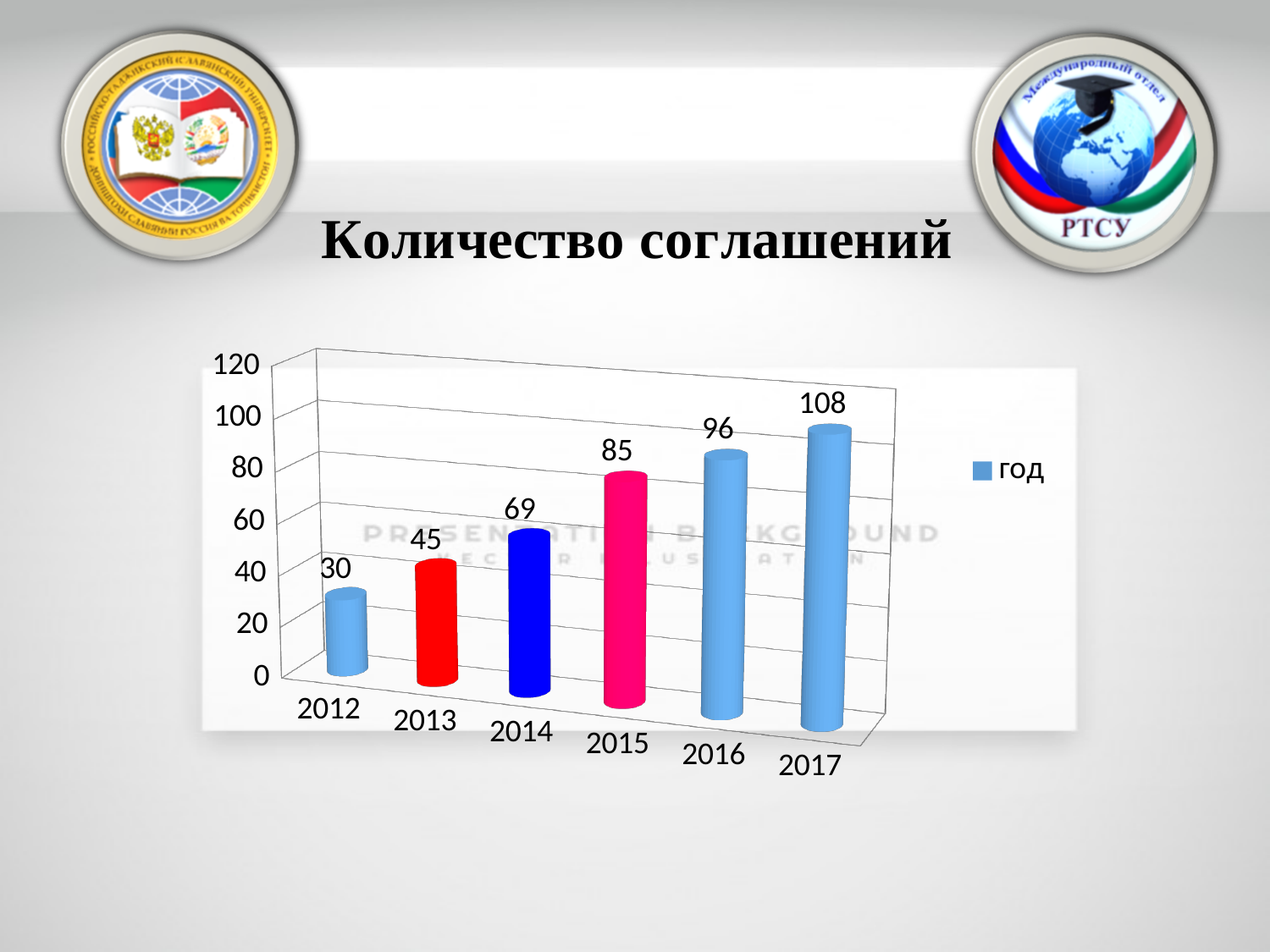
Which year has the lowest value? 2012 Which is larger, the value for 2014 or the value for 2013? 2014 Is the value for 2016 greater or less than 100? less What kind of chart is shown? bar chart What is the value for 2017? 108 How many years are shown on the x axis? 6 What is the difference between the values for 2016 and 2015? 11 What is the difference between the values for 2017 and 2012? 78 What is the value for 2012? 30 Which year has the highest value? 2017 Do the values rise or fall from 2012 to 2017? rise What is the value for 2015? 85